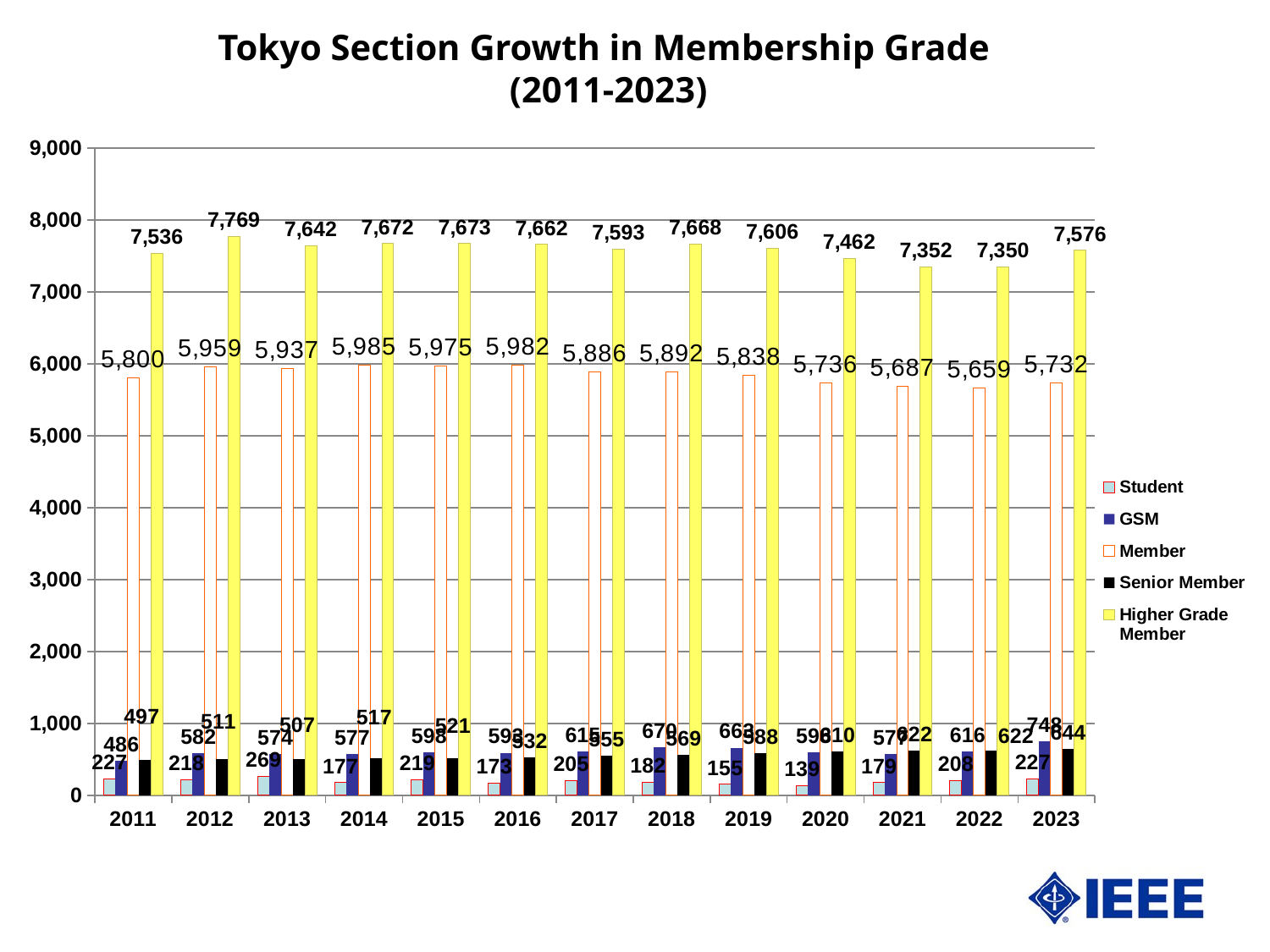
How many series does the legend list? 5 What is the difference between the Higher Grade Member values for 2012 and 2011? 233 In which year is the Member value lowest? 2022 What is the Higher Grade Member value for 2012? 7,769 What colour are the Higher Grade Member bars? Yellow In which year is the Higher Grade Member value highest? 2012 Is the Higher Grade Member value for 2021 greater or less than 7,000? greater What is the Member value for 2011? 5,800 What is the Student value for 2020? 139 Which year has the larger Higher Grade Member value, 2020 or 2021? 2020 How many years are shown on the x axis? 13 What kind of chart is shown on the slide? Bar chart